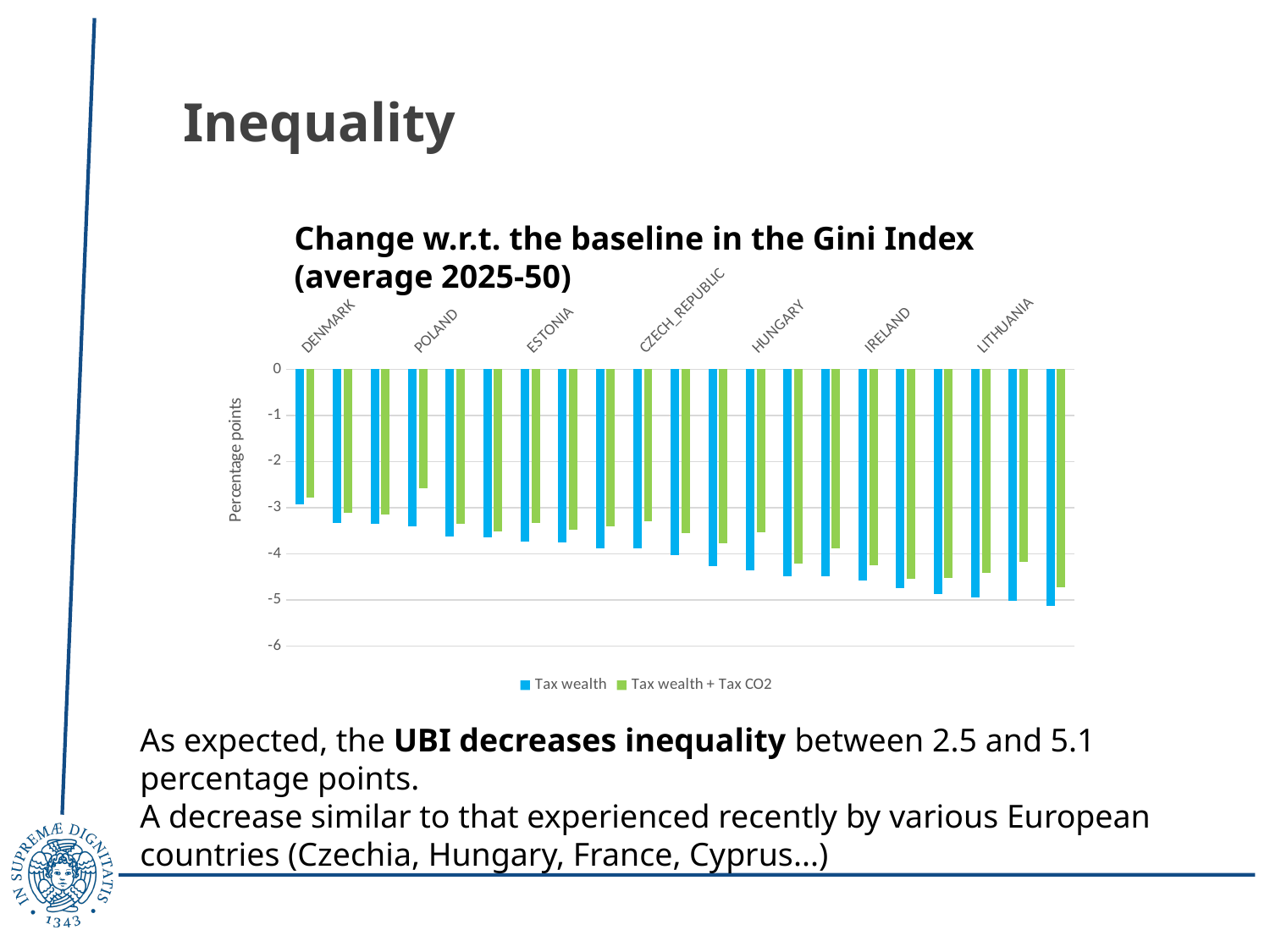
Is the Tax wealth value for LITHUANIA greater or less than -4? less Is the Tax wealth + Tax CO2 value for POLAND greater or less than -3? greater What is the label of the vertical axis? Percentage points How many series does the legend list? 2 Is the Tax wealth value for HUNGARY greater or less than -4? less What kind of chart is shown on the slide? Bar chart Do the Tax wealth values rise or fall moving from left to right along the x axis? fall How many country labels are shown along the x axis? 7 What are the two series named in the legend? Tax wealth; Tax wealth + Tax CO2 Among the labelled countries, which has the highest (least negative) Tax wealth value? DENMARK Among the labelled countries, which has the lowest (most negative) Tax wealth value? LITHUANIA